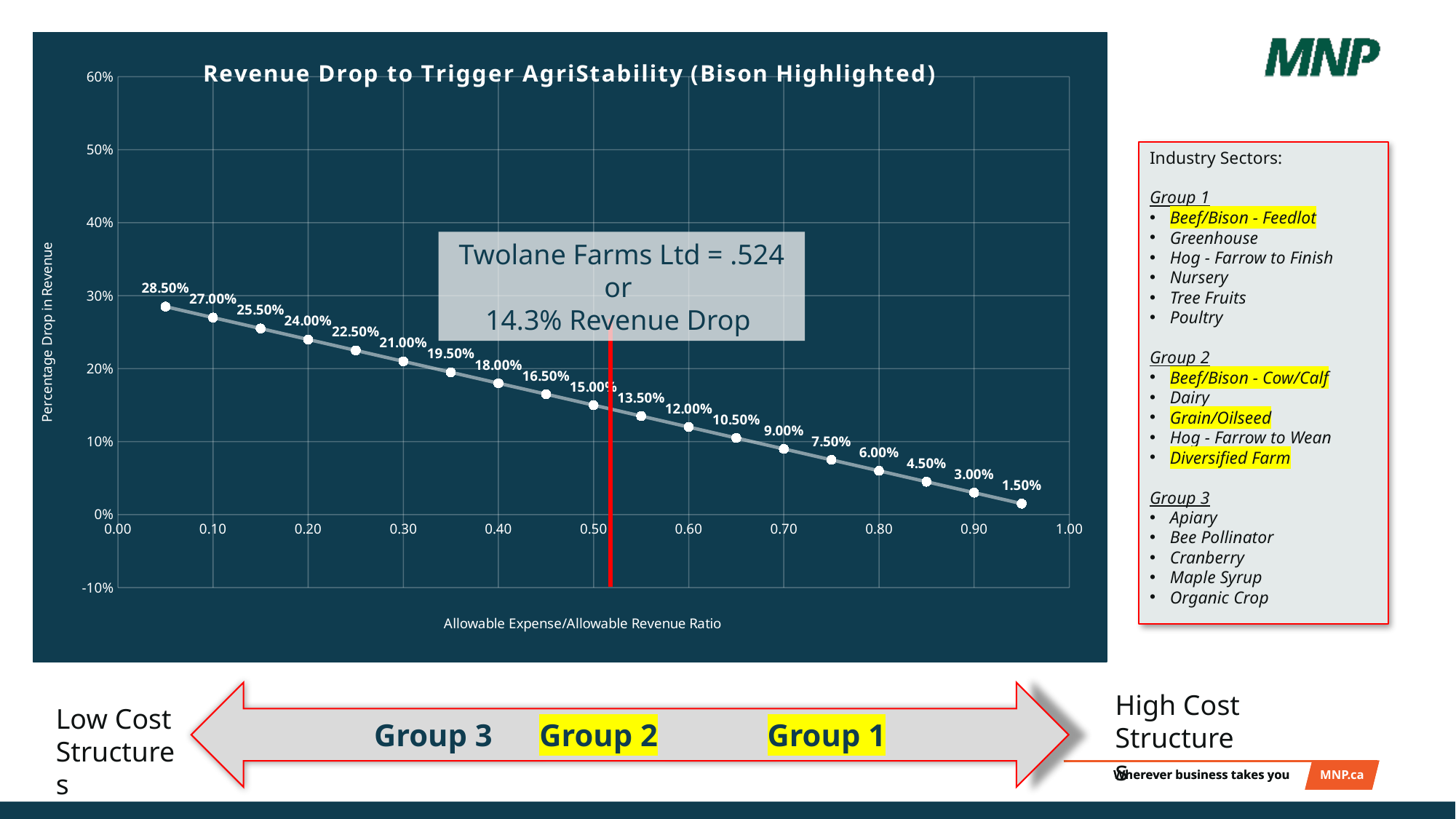
Which is larger, the percentage drop at a ratio of 0.40 or at a ratio of 0.60? 0.40 What is the percentage drop in revenue at an allowable expense/allowable revenue ratio of 0.80? 6.00% How many data points are plotted on the line? 19 What is the percentage drop in revenue at an allowable expense/allowable revenue ratio of 0.20? 24.00% What is the percentage drop in revenue at an allowable expense/allowable revenue ratio of 0.50? 15.00% Do the values rise or fall as the allowable expense/allowable revenue ratio increases? fall What is the lowest data label shown on the line? 1.50% What kind of chart is shown on the slide? line chart What is the title of the chart? Revenue Drop to Trigger AgriStability (Bison Highlighted) What is the label on the x axis of the chart? Allowable Expense/Allowable Revenue Ratio What is the difference between the percentage drop at a ratio of 0.30 and at a ratio of 0.70? 12.00% What is the highest data label shown on the line? 28.50%